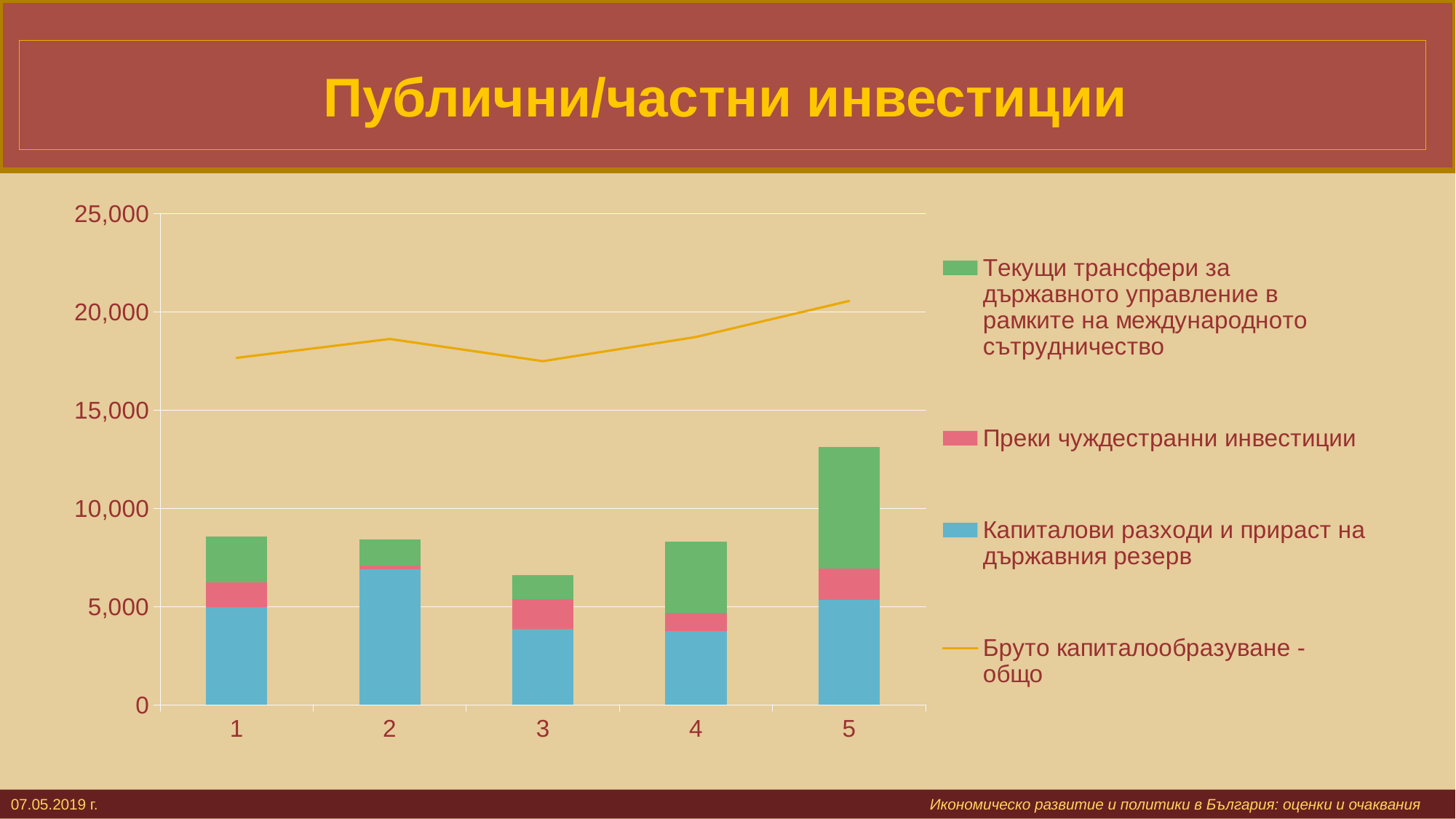
Which category has the shortest stacked bar? 3 Is the total height of the stacked bar for category 3 greater or less than 10,000? less How many series does the chart's legend list? 4 Which category has the tallest stacked bar? 5 Which category has the larger stacked bar total, category 1 or category 5? 5 What is the title of the chart on the slide? Публични/частни инвестиции Is the value of 'Капиталови разходи и прираст на държавния резерв' for category 4 greater or less than 5,000? less Is the total height of the stacked bar for category 5 greater or less than 10,000? greater Which series in the chart is drawn as a line rather than as stacked bars? Бруто капиталообразуване - общо How many categories are shown on the x axis of the chart? 5